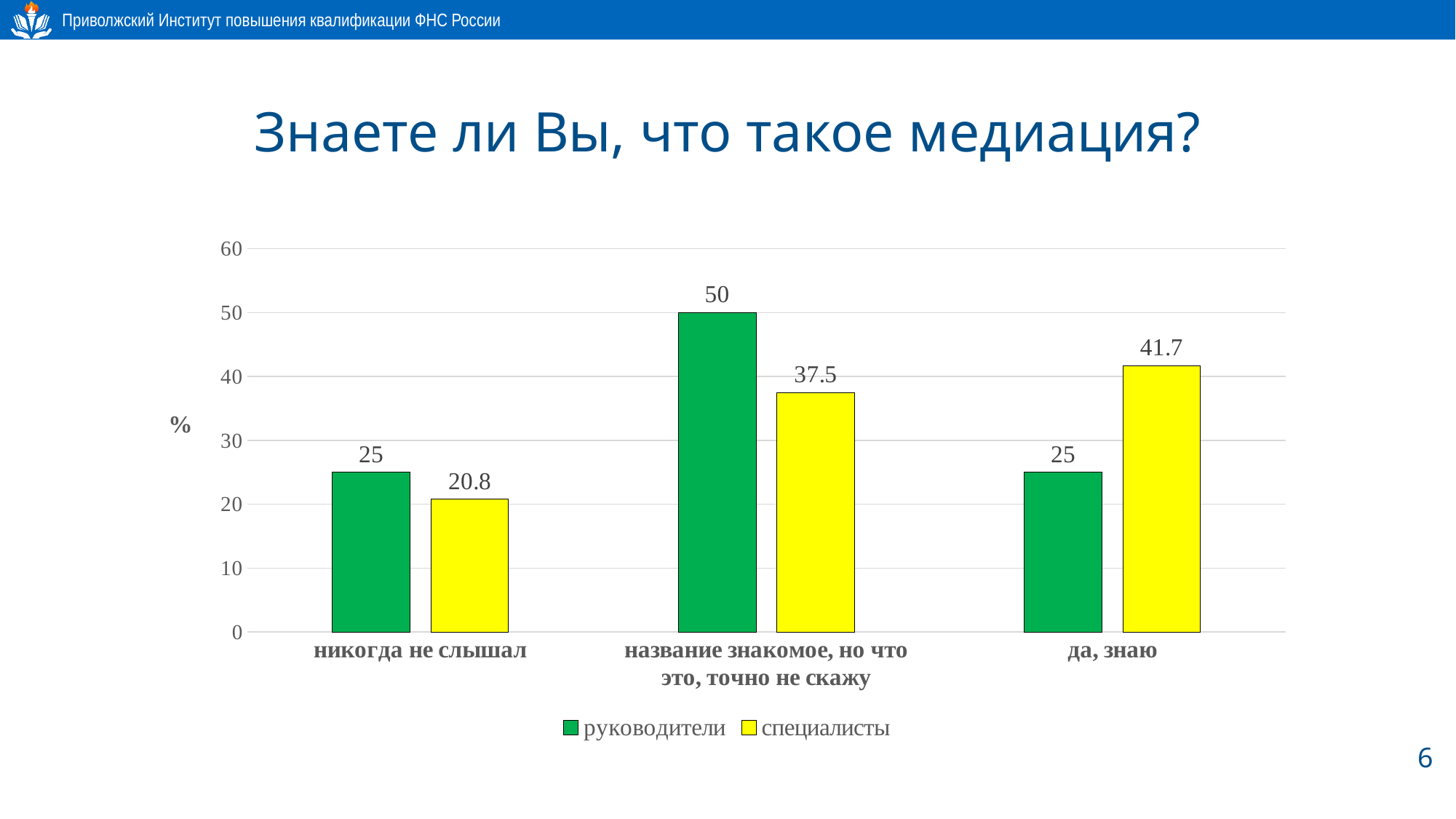
What colour are the bars for специалисты? yellow Which category has the highest value for руководители? название знакомое, но что это, точно не скажу What is the value for специалисты in the category 'да, знаю'? 41.7 How many series does the legend list? 2 How many categories are shown on the x axis? 3 What is the difference between руководители and специалисты in the category 'название знакомое, но что это, точно не скажу'? 12.5 What is the value for специалисты in the category 'название знакомое, но что это, точно не скажу'? 37.5 What is the title of the slide? Знаете ли Вы, что такое медиация? What is the value for руководители in the category 'никогда не слышал'? 25 In the category 'да, знаю', which series has the larger value, руководители or специалисты? специалисты Which category has the lowest value for специалисты? никогда не слышал What kind of chart is shown on the slide? bar chart